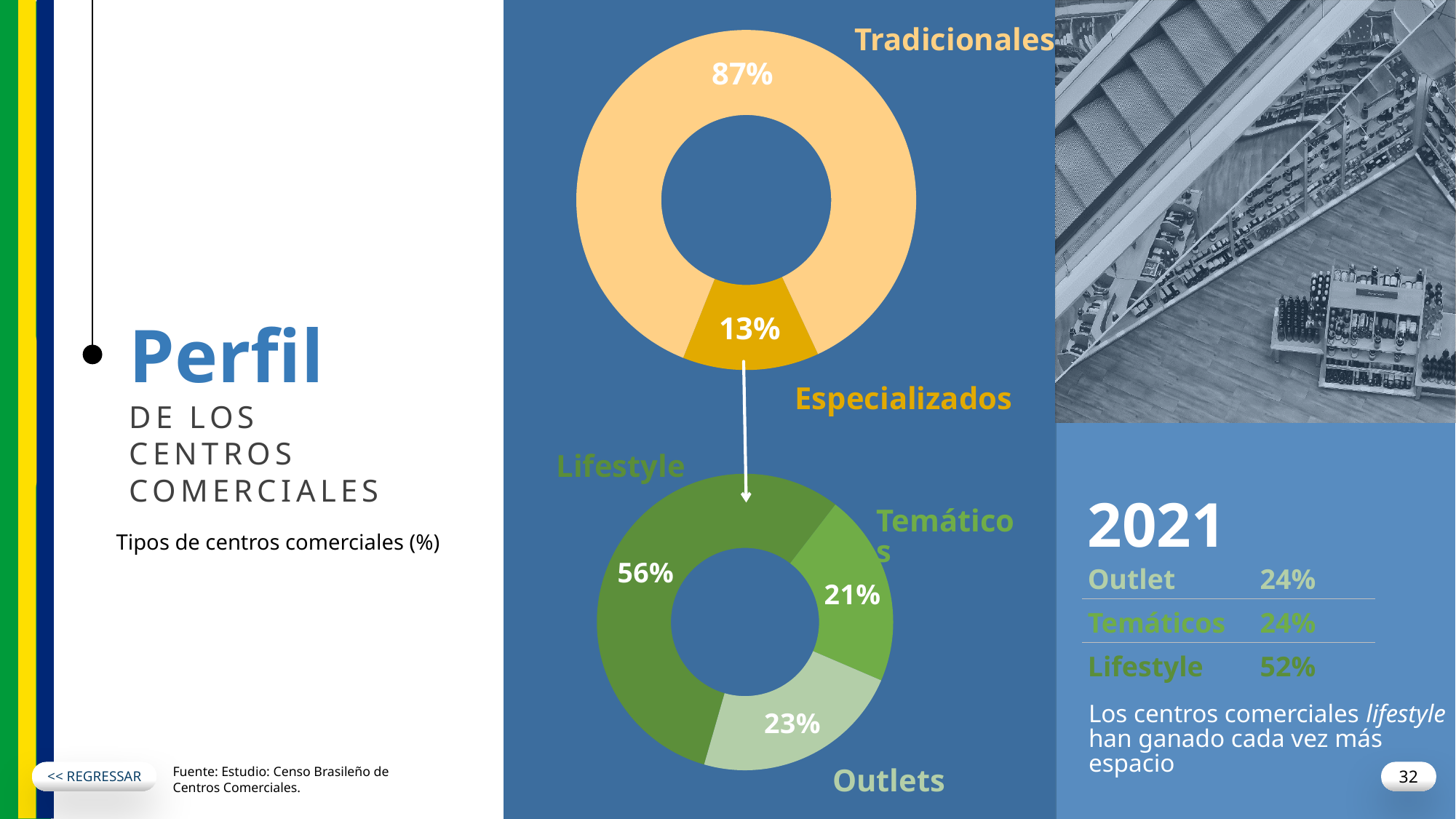
In the bottom donut chart, which category has the largest share? Lifestyle What is the subtitle describing what the charts show, printed under the slide title? Tipos de centros comerciales (%) In the top donut chart, what percentage is shown for Tradicionales? 87% What type of chart is used for the top chart on the slide? Donut chart In the bottom donut chart, what percentage is shown for Outlets? 23% How many categories does the bottom donut chart show? 3 In the top donut chart, what percentage is shown for Especializados? 13% In the bottom donut chart, what percentage is shown for Lifestyle? 56% In the bottom donut chart, what percentage is shown for Temáticos? 21% In the bottom donut chart, which is larger, Outlets or Temáticos? Outlets In the bottom donut chart, which category has the smallest share? Temáticos In the top donut chart, what is the difference in percentage points between Tradicionales and Especializados? 74